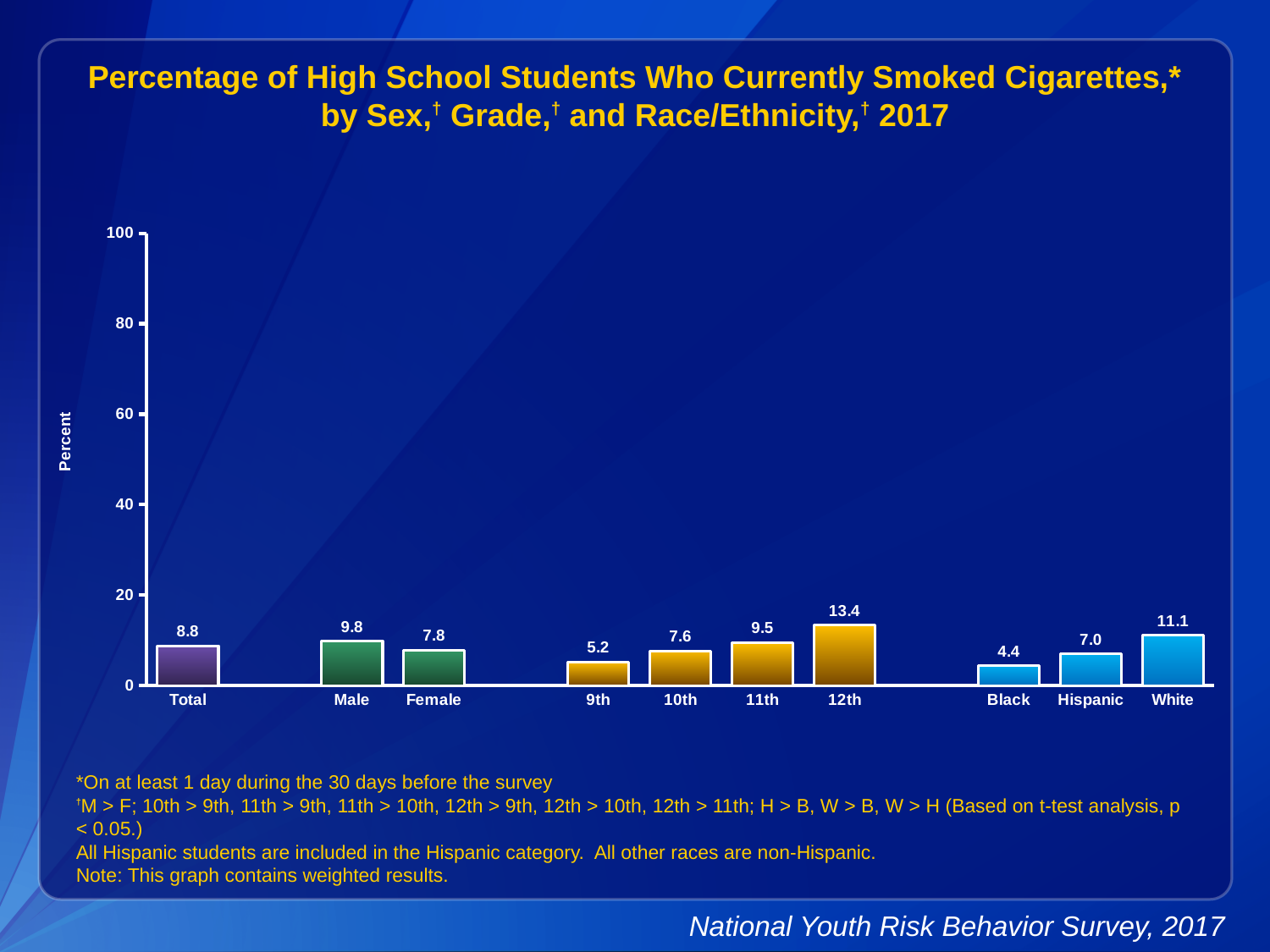
Which category has the highest value? 12th How many categories are shown on the x axis? 10 What is the difference between the values for Male and Female? 2.0 What kind of chart is this? bar chart What is the value for 12th grade? 13.4 Which category has the lowest value? Black Which is larger, the value for 10th grade or the value for 11th grade? 11th What is the difference between the values for White and Hispanic? 4.1 Is the value for 12th grade greater or less than 20? less Do the values rise or fall from 9th grade to 12th grade? rise What is the value for Total? 8.8 What is the value for Black students? 4.4